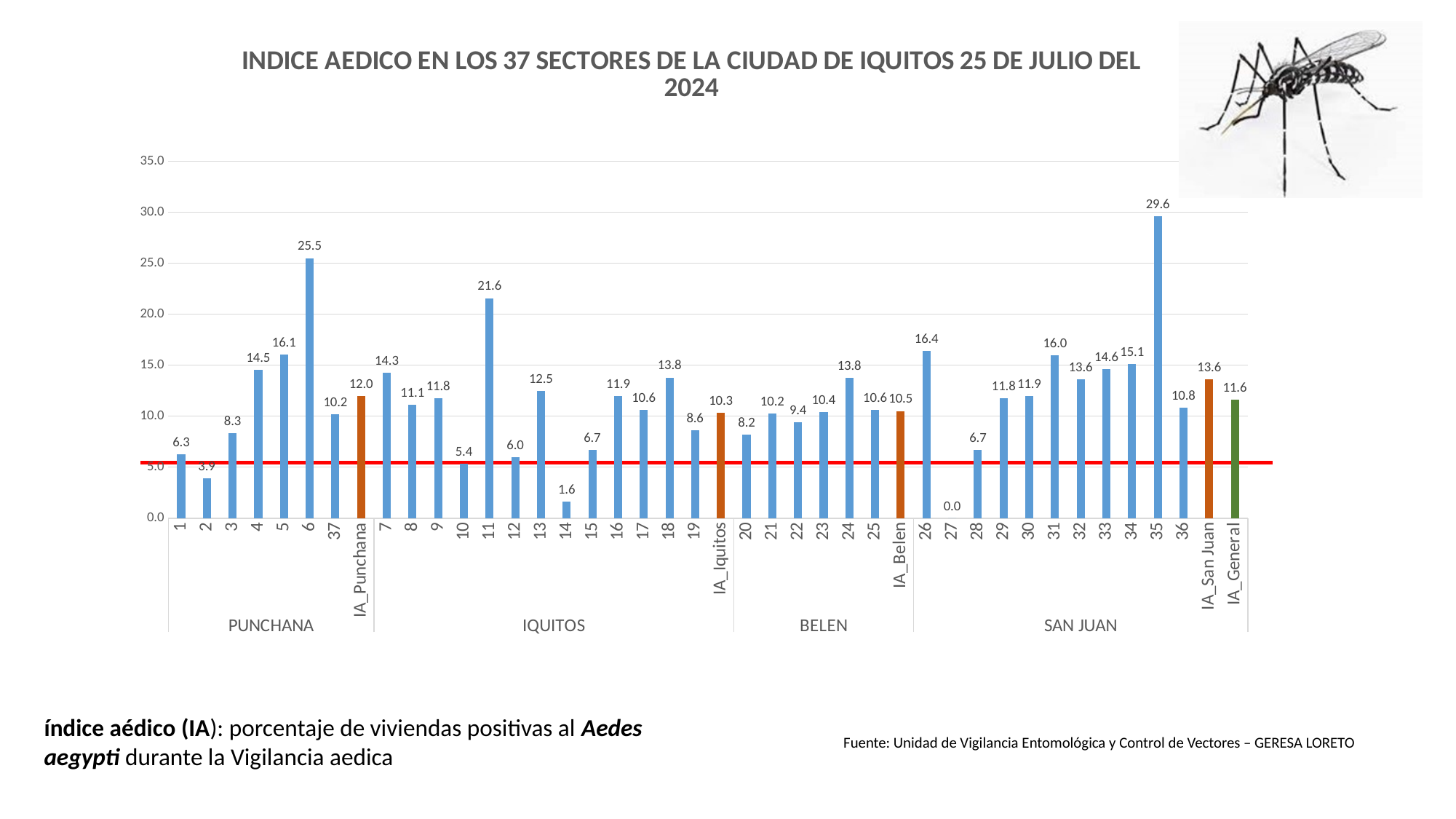
What is the value for IA_General? 11.6 Which is larger, the value for sector 6 or the value for sector 11? sector 6 What is the value for IA_Punchana? 12.0 What is the value for sector 35? 29.6 What is the value for sector 14? 1.6 What is the difference between the values for sector 6 and sector 11? 3.9 How many district groups are shown along the x axis? 4 Which sector has the highest value? 35 Which sector has the lowest value? 27 What is the difference between IA_San Juan and IA_Belen? 3.1 What kind of chart is this? bar chart